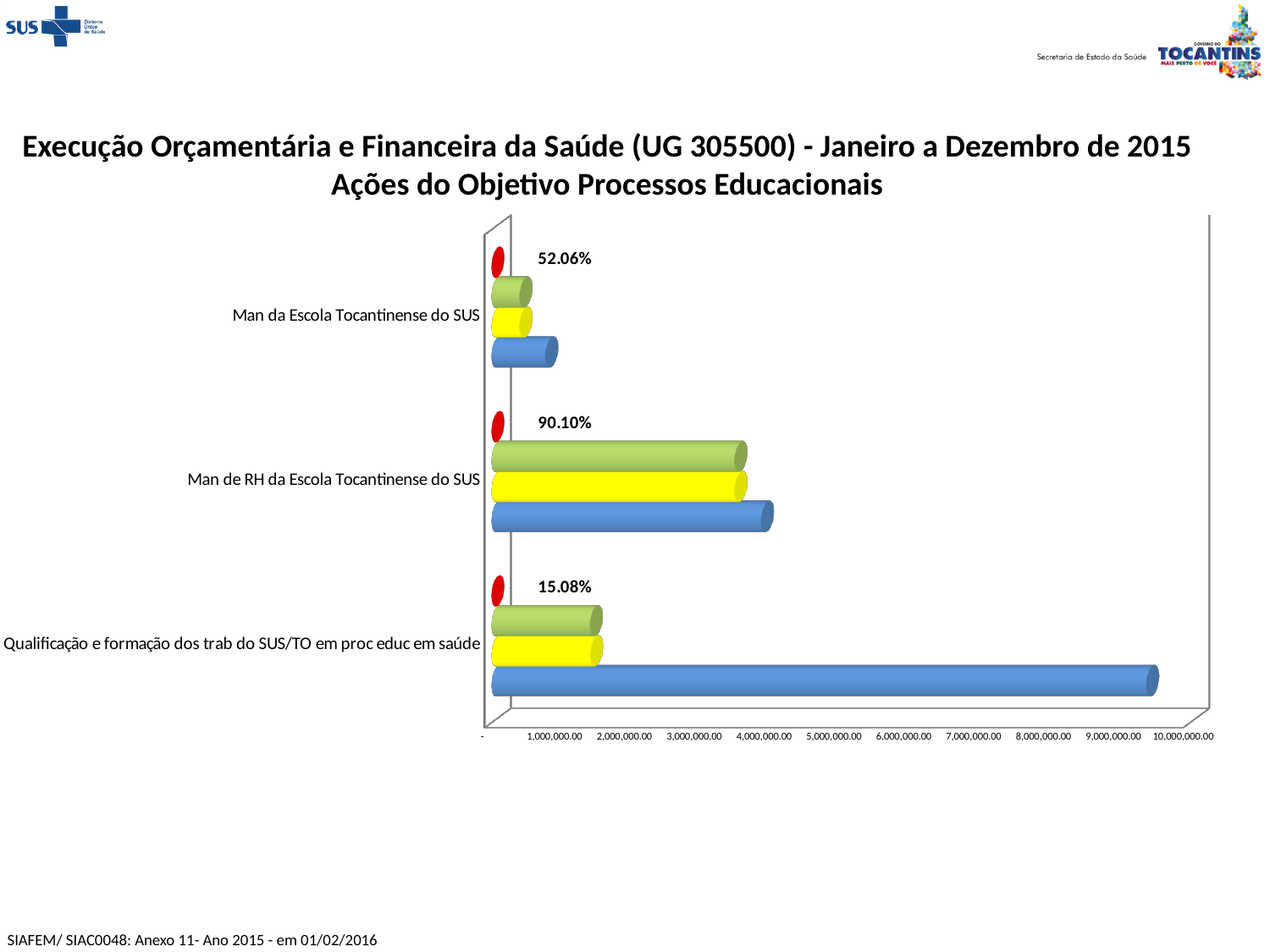
What kind of chart is shown on the slide? Bar chart Is the value of the blue bar for Man da Escola Tocantinense do SUS greater or less than 1,000,000.00? less Which category has the highest percentage label? Man de RH da Escola Tocantinense do SUS How many categories are shown on the chart? 3 Which category has the lowest percentage label? Qualificação e formação dos trab do SUS/TO em proc educ em saúde Which has a higher percentage label, Man da Escola Tocantinense do SUS or Man de RH da Escola Tocantinense do SUS? Man de RH da Escola Tocantinense do SUS Is the value of the green bar for Man de RH da Escola Tocantinense do SUS greater or less than 3,000,000.00? greater What percentage is shown for Qualificação e formação dos trab do SUS/TO em proc educ em saúde? 15.08% What percentage is shown for Man de RH da Escola Tocantinense do SUS? 90.10% What is the difference between the percentage labels for Man de RH da Escola Tocantinense do SUS and Qualificação e formação dos trab do SUS/TO em proc educ em saúde? 75.02% What percentage is shown for Man da Escola Tocantinense do SUS? 52.06% Is the value of the blue bar for Qualificação e formação dos trab do SUS/TO em proc educ em saúde greater or less than 9,000,000.00? greater